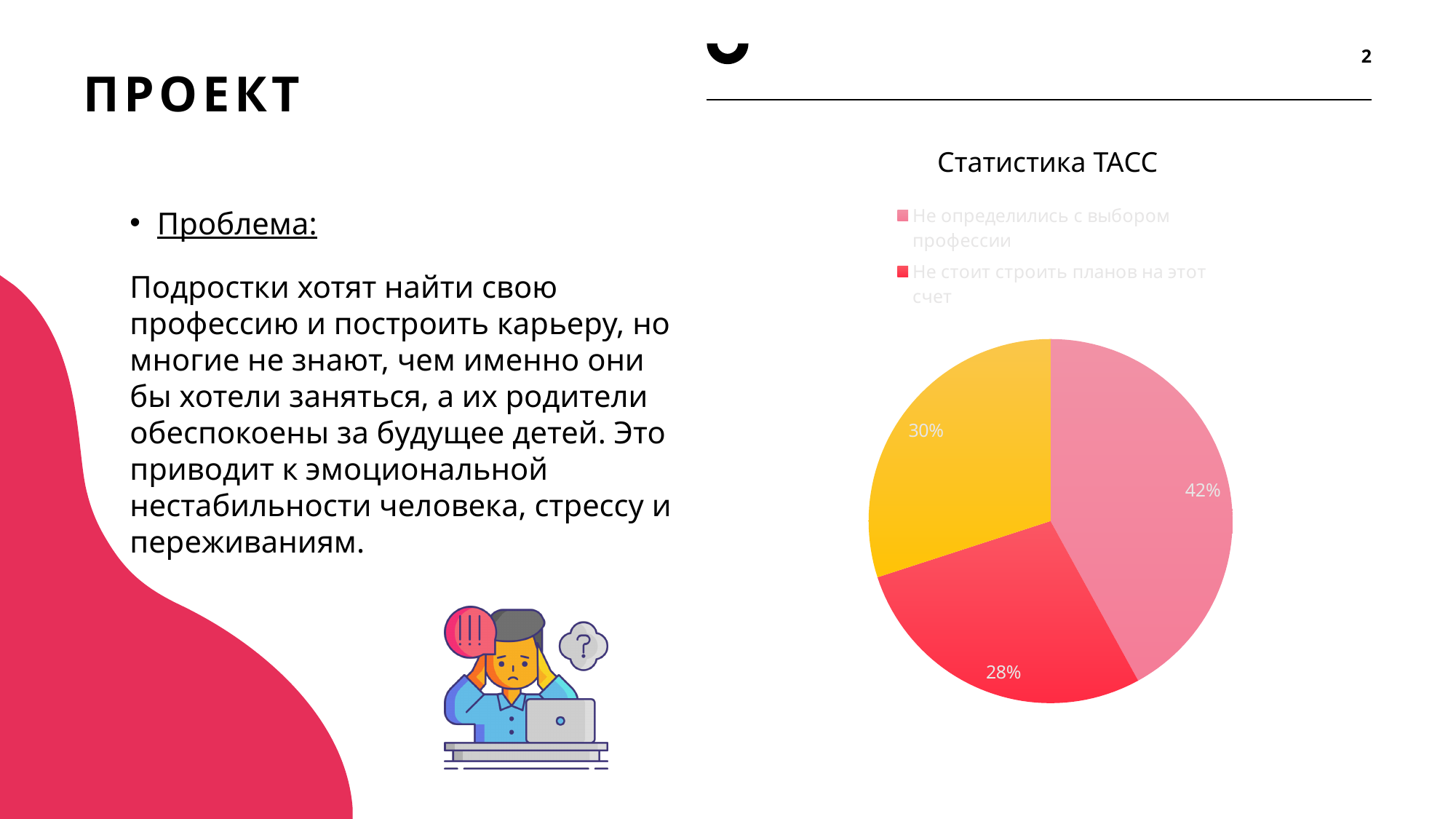
What percentage of the pie is labelled "Не стоит строить планов на этот счет"? 28% Which slice of the pie is the smallest? Не стоит строить планов на этот счет How many slices does the pie chart have? 3 What is the total of all the percentages shown on the pie chart? 100% What percentage of the pie is labelled "Не определились с выбором профессии"? 42% Which slice of the pie is the largest? Не определились с выбором профессии What type of chart is shown on the slide? pie chart What is the difference between the "Не определились с выбором профессии" slice and the "Не стоит строить планов на этот счет" slice? 14% What is the title of the chart? Статистика ТАСС What value is shown on the yellow slice of the pie? 30% How many entries does the chart legend list? 2 Which is larger: the yellow slice or the "Не стоит строить планов на этот счет" slice? the yellow slice